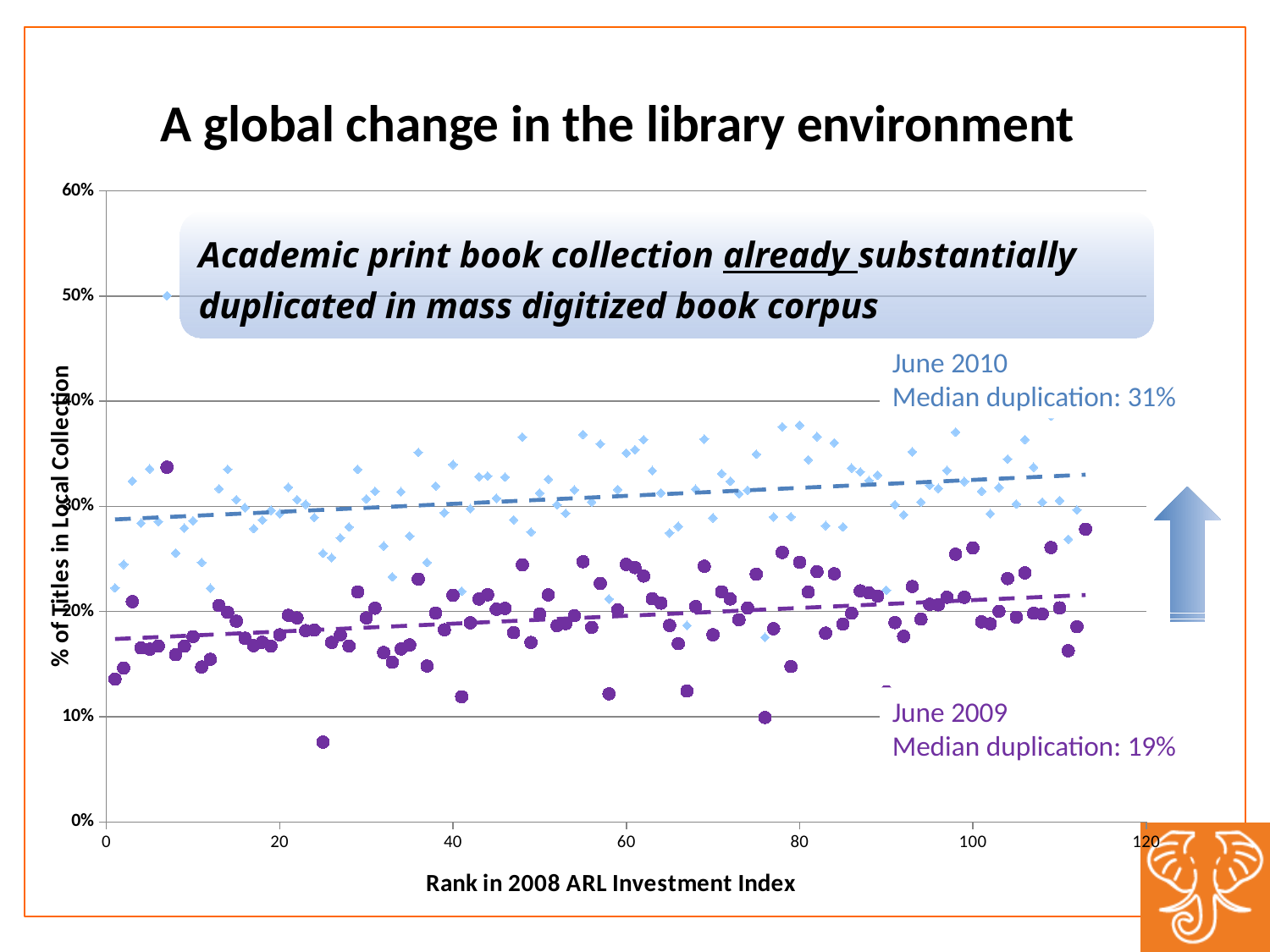
What is the label of the x axis? Rank in 2008 ARL Investment Index What is the label of the y axis? % of Titles in Local Collection Which series has the higher median duplication, June 2010 or June 2009? June 2010 Is the June 2010 median duplication greater or less than 30%? greater Is the June 2009 median duplication greater or less than 20%? less What is the median duplication for June 2010 according to the chart annotation? 31% What kind of chart is shown on the slide? Scatter chart What is the median duplication for June 2009 according to the chart annotation? 19% Does the dashed trend line for the June 2010 series rise or fall as rank increases along the x axis? Rises What is the maximum value shown on the y axis? 60% How many data series are plotted on the chart? 2 What is the difference between the June 2010 and June 2009 median duplication values? 12 percentage points